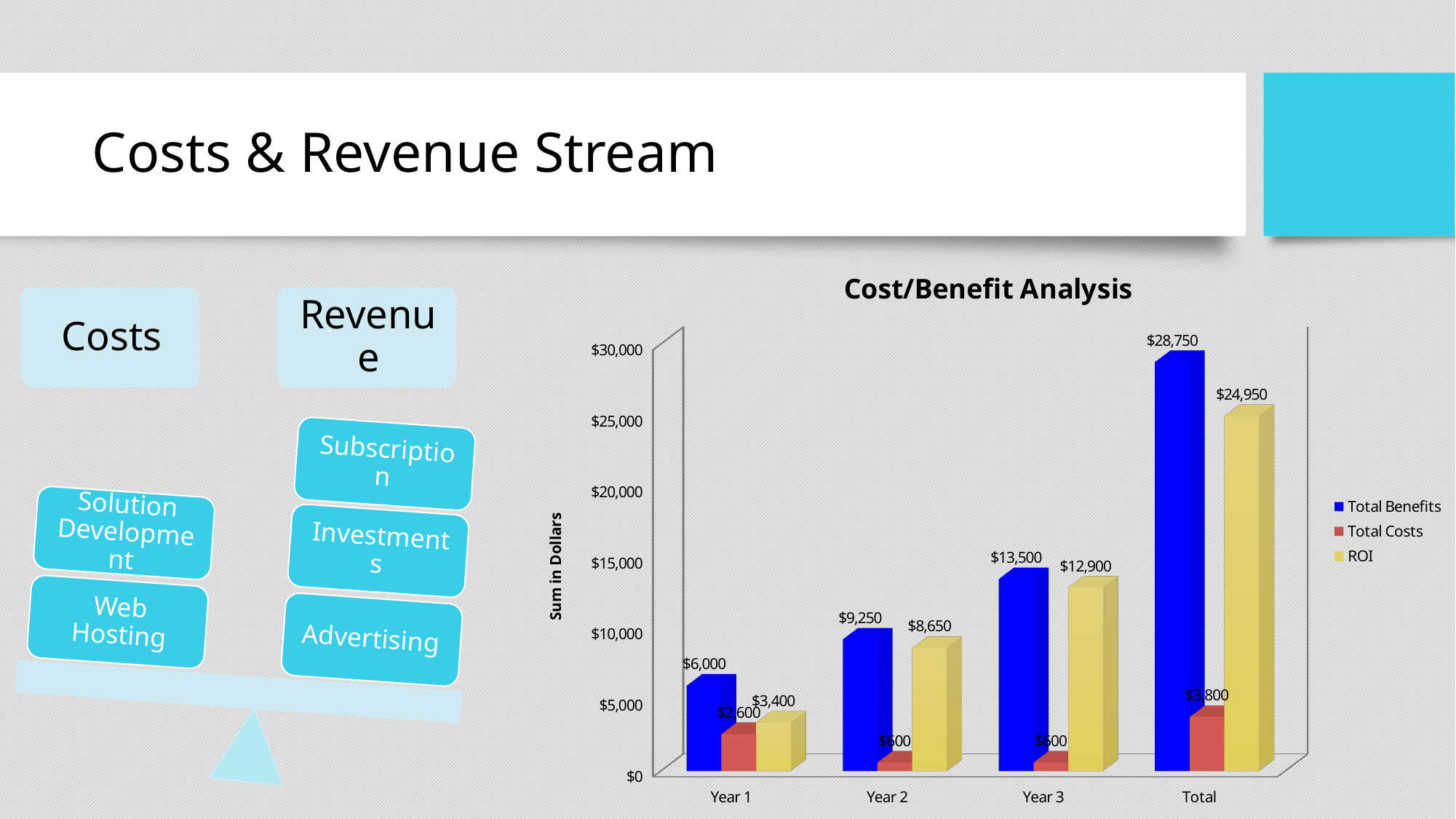
What is the Total Benefits value for Year 2? $9,250 How many series does the legend list? 3 What kind of chart is shown? Bar chart What is the difference between Total Benefits and ROI for Year 3? $600 How many categories are shown on the x axis? 4 Which category has the highest ROI value? Total What is the Total Benefits value for the Total category? $28,750 What is the title of the chart? Cost/Benefit Analysis Which is larger, the ROI for Year 2 or the Total Benefits for Year 1? ROI for Year 2 What is the ROI value for Year 3? $12,900 Among Year 1, Year 2 and Year 3, which year has the lowest Total Benefits? Year 1 What is the Total Costs value for Year 1? $2,600